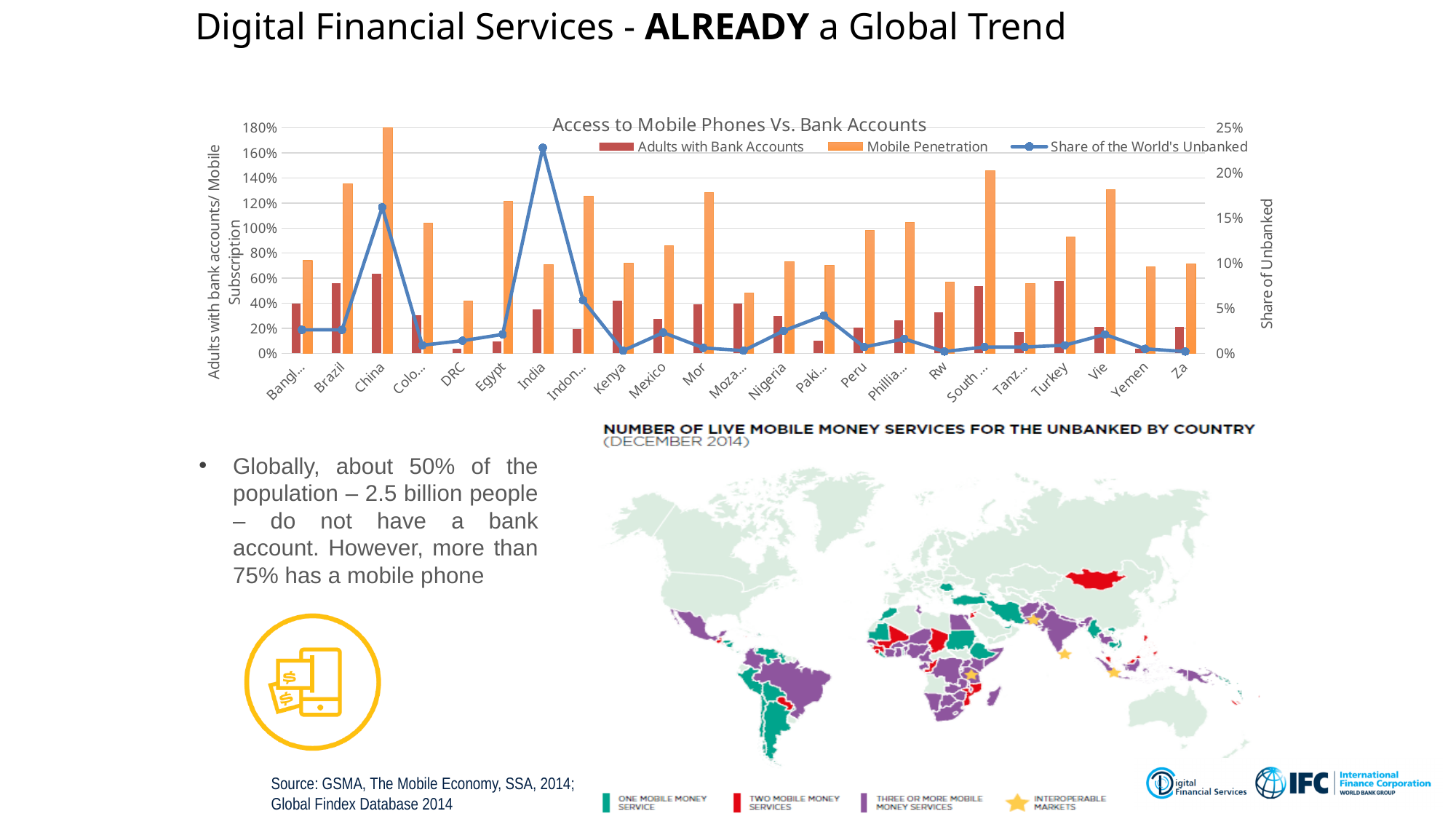
In the 'Access to Mobile Phones Vs. Bank Accounts' chart, which country has the highest Share of the World's Unbanked? India In the 'Access to Mobile Phones Vs. Bank Accounts' chart, is the Mobile Penetration value for Kenya greater or less than 100%? less In the 'Access to Mobile Phones Vs. Bank Accounts' chart, is the Mobile Penetration value for Brazil greater or less than 100%? greater What is the title of the chart at the top of the slide? Access to Mobile Phones Vs. Bank Accounts What is the label of the right-hand vertical axis in the 'Access to Mobile Phones Vs. Bank Accounts' chart? Share of Unbanked In the 'Access to Mobile Phones Vs. Bank Accounts' chart, which country has the lowest Mobile Penetration? DRC In the 'Access to Mobile Phones Vs. Bank Accounts' chart, which country has the highest Mobile Penetration? China In the 'Access to Mobile Phones Vs. Bank Accounts' chart, which has the higher share of Adults with Bank Accounts, Brazil or Peru? Brazil In the 'Access to Mobile Phones Vs. Bank Accounts' chart, is the Share of the World's Unbanked for India greater or less than 20%? greater How many series does the legend of the 'Access to Mobile Phones Vs. Bank Accounts' chart list? 3 What kind of chart is 'Access to Mobile Phones Vs. Bank Accounts'? Combined bar and line chart In the 'Access to Mobile Phones Vs. Bank Accounts' chart, which has the higher Mobile Penetration, Turkey or Vie? Vie